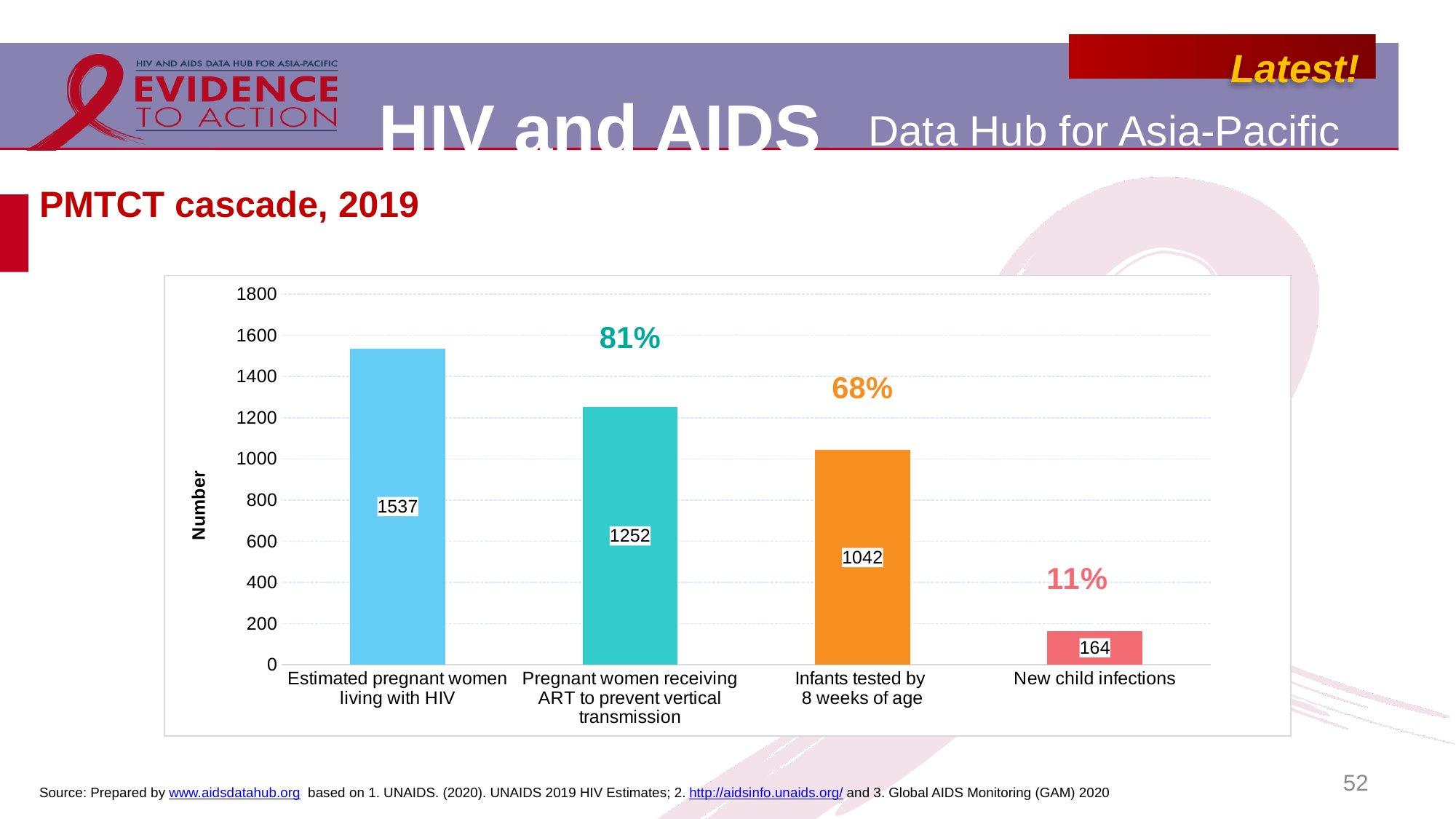
What is the value for New child infections? 164 Do the values rise or fall from left to right along the x axis? Fall What is the value for Pregnant women receiving ART to prevent vertical transmission? 1252 Which category has the highest value? Estimated pregnant women living with HIV What is the value for Estimated pregnant women living with HIV? 1537 Which category has the lowest value? New child infections Which is larger: Infants tested by 8 weeks of age or New child infections? Infants tested by 8 weeks of age What percentage is shown above the bar for Infants tested by 8 weeks of age? 68% What is the difference between Estimated pregnant women living with HIV and Pregnant women receiving ART to prevent vertical transmission? 285 What kind of chart is shown on the slide? Bar chart How many categories are shown in the chart? 4 What is the value for Infants tested by 8 weeks of age? 1042